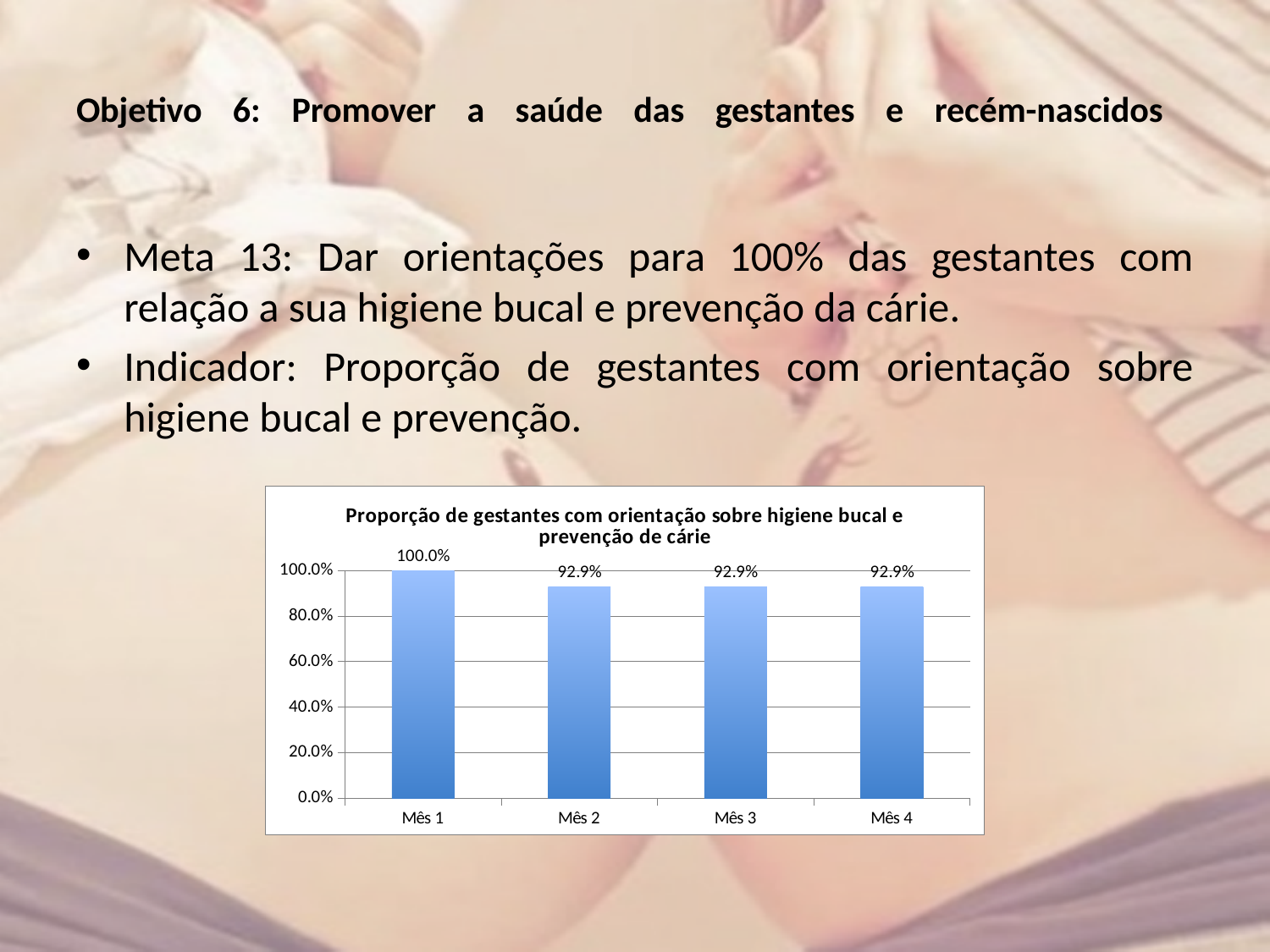
Which is larger, the value for Mês 1 or the value for Mês 4? Mês 1 Is the value for Mês 2 greater or less than 80.0%? greater What is the value for Mês 4? 92.9% How many months are shown on the x axis? 4 What is the value for Mês 1? 100.0% What is the difference between the values for Mês 1 and Mês 2? 7.1% What kind of chart is shown on the slide? Bar chart What is the value for Mês 3? 92.9% What is the title of the chart? Proporção de gestantes com orientação sobre higiene bucal e prevenção de cárie Do the values rise or fall from Mês 1 to Mês 2? Fall Which month has the highest value? Mês 1 What is the highest value shown on the y axis? 100.0%